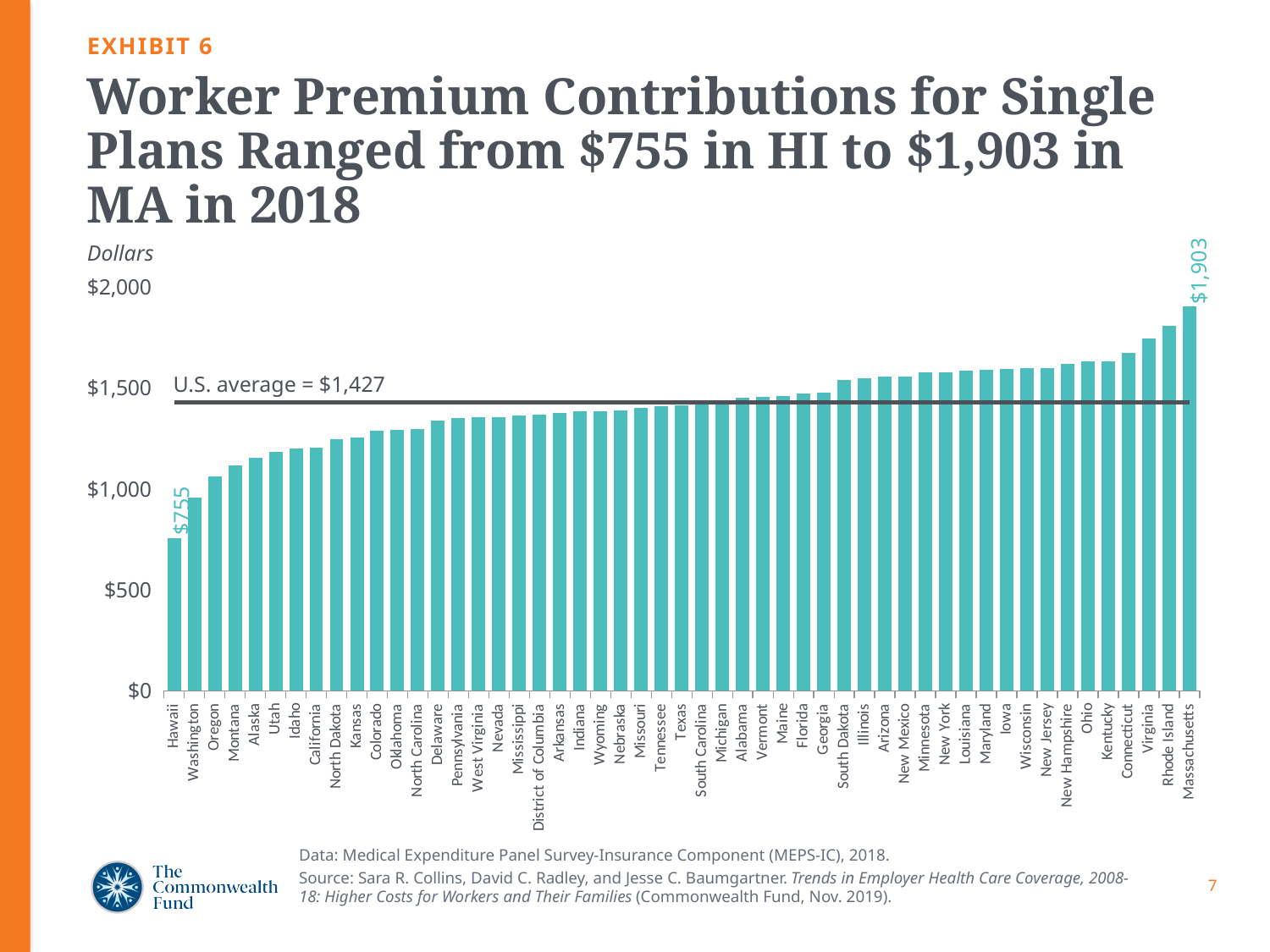
Which state has the lowest worker premium contribution for single plans? Hawaii What is the U.S. average worker premium contribution shown on the chart? $1,427 What kind of chart is shown on the slide? Bar chart Is the value for Oregon greater or less than $1,000? greater Which has a larger worker premium contribution, Virginia or Idaho? Virginia How many states and districts are shown on the chart? 51 Is the value for Rhode Island greater or less than $1,500? greater What is the difference between the worker premium contribution in Massachusetts and in Hawaii? $1,148 Is the value for Texas greater or less than $1,500? less What is the worker premium contribution for single plans in Hawaii? $755 What is the worker premium contribution for single plans in Massachusetts? $1,903 Which state has the highest worker premium contribution for single plans? Massachusetts